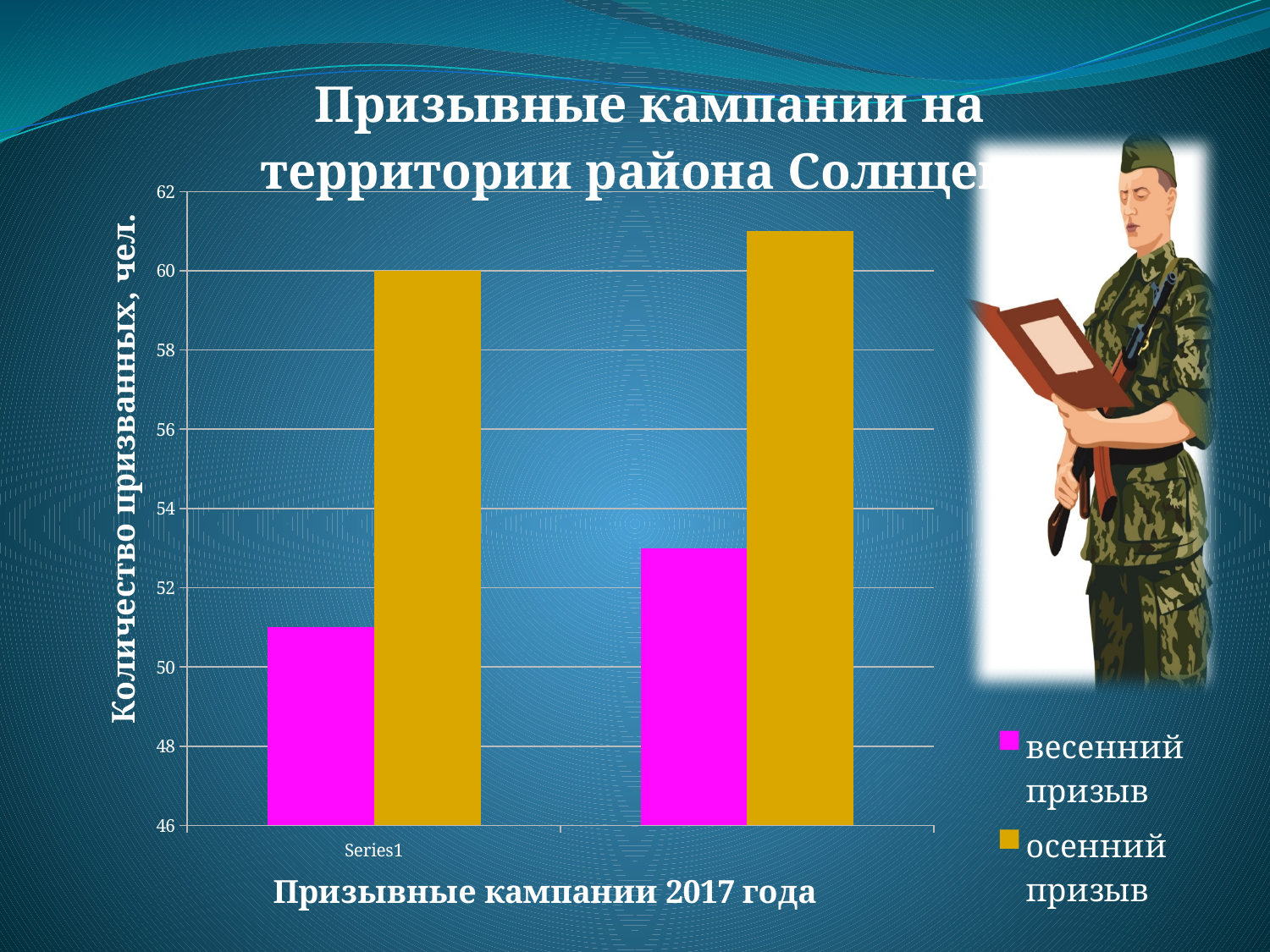
What is the title of the vertical axis? Количество призванных, чел. Does the value for весенний призыв rise or fall from the first group of bars to the second? rise Is the value for весенний призыв in Series1 greater or less than 50? greater How many series does the legend list? 2 What kind of chart is shown on the slide? bar chart How many groups of bars are plotted on the chart? 2 Is the value for весенний призыв in the second group of bars greater or less than 54? less Is the value for весенний призыв in the second group of bars greater or less than 52? greater What is the value of осенний призыв for Series1? 60 In Series1, which is larger: весенний призыв or осенний призыв? осенний призыв